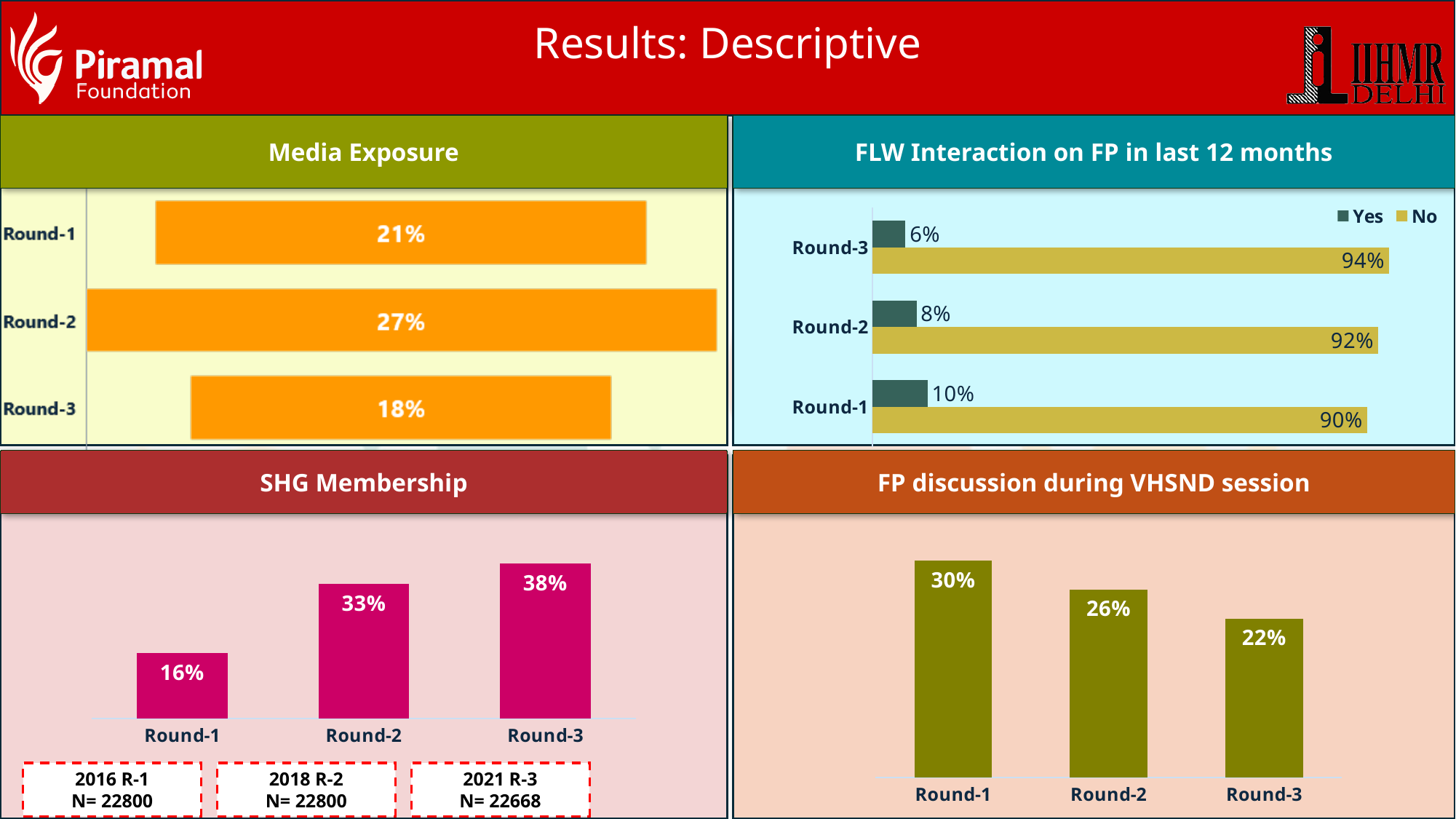
In the Media Exposure chart, what is the value for Round-2? 27% In the FLW Interaction on FP in last 12 months chart, what is the difference between the No values for Round-3 and Round-1? 4% In the SHG Membership chart, do the values rise or fall from Round-1 to Round-3? rise In the FLW Interaction on FP in last 12 months chart, what is the Yes value for Round-1? 10% In the Media Exposure chart, which round has the lowest value? Round-3 In the FP discussion during VHSND session chart, which round has the highest value? Round-1 What kind of chart is the FP discussion during VHSND session chart? bar chart In the FLW Interaction on FP in last 12 months chart, what is the No value for Round-3? 94% In the SHG Membership chart, what is the difference between Round-2 and Round-1? 17% In the SHG Membership chart, what is the value for Round-3? 38% How many series does the legend list in the FLW Interaction on FP in last 12 months chart? 2 In the FP discussion during VHSND session chart, which is larger, Round-2 or Round-3? Round-2